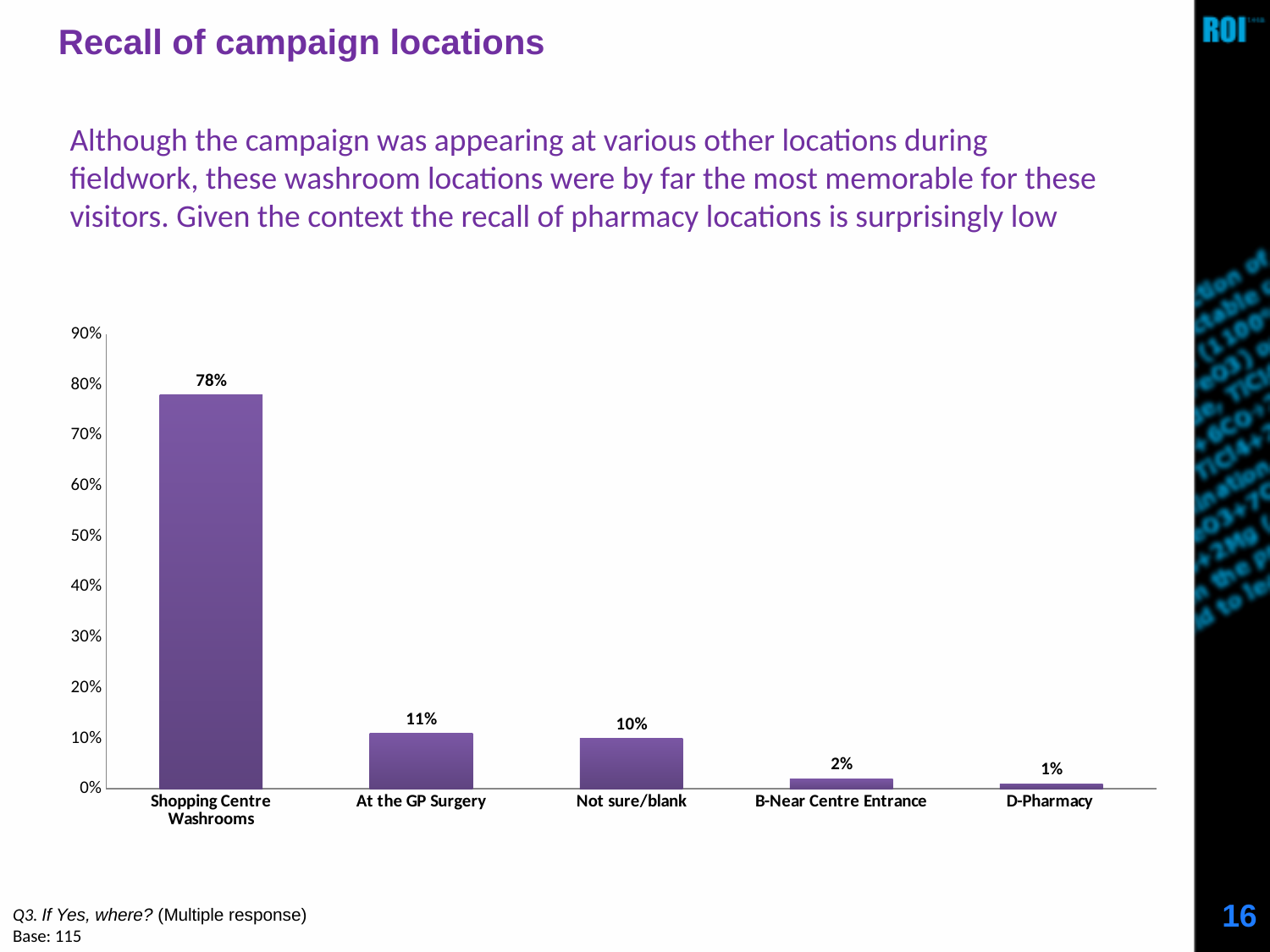
How many locations are shown on the chart? 5 What is the value for Not sure/blank? 10% What is the difference between the values for B-Near Centre Entrance and D-Pharmacy? 1% Which location has the highest recall? Shopping Centre Washrooms What is the value for D-Pharmacy? 1% Which is larger, the value for At the GP Surgery or the value for B-Near Centre Entrance? At the GP Surgery Which location has the lowest recall? D-Pharmacy What percentage of visitors recalled the campaign at Shopping Centre Washrooms? 78% What kind of chart is shown on the slide? Bar chart What is the difference between the values for Shopping Centre Washrooms and At the GP Surgery? 67% What is the value for At the GP Surgery? 11% Is the value for Shopping Centre Washrooms greater or less than 70%? greater